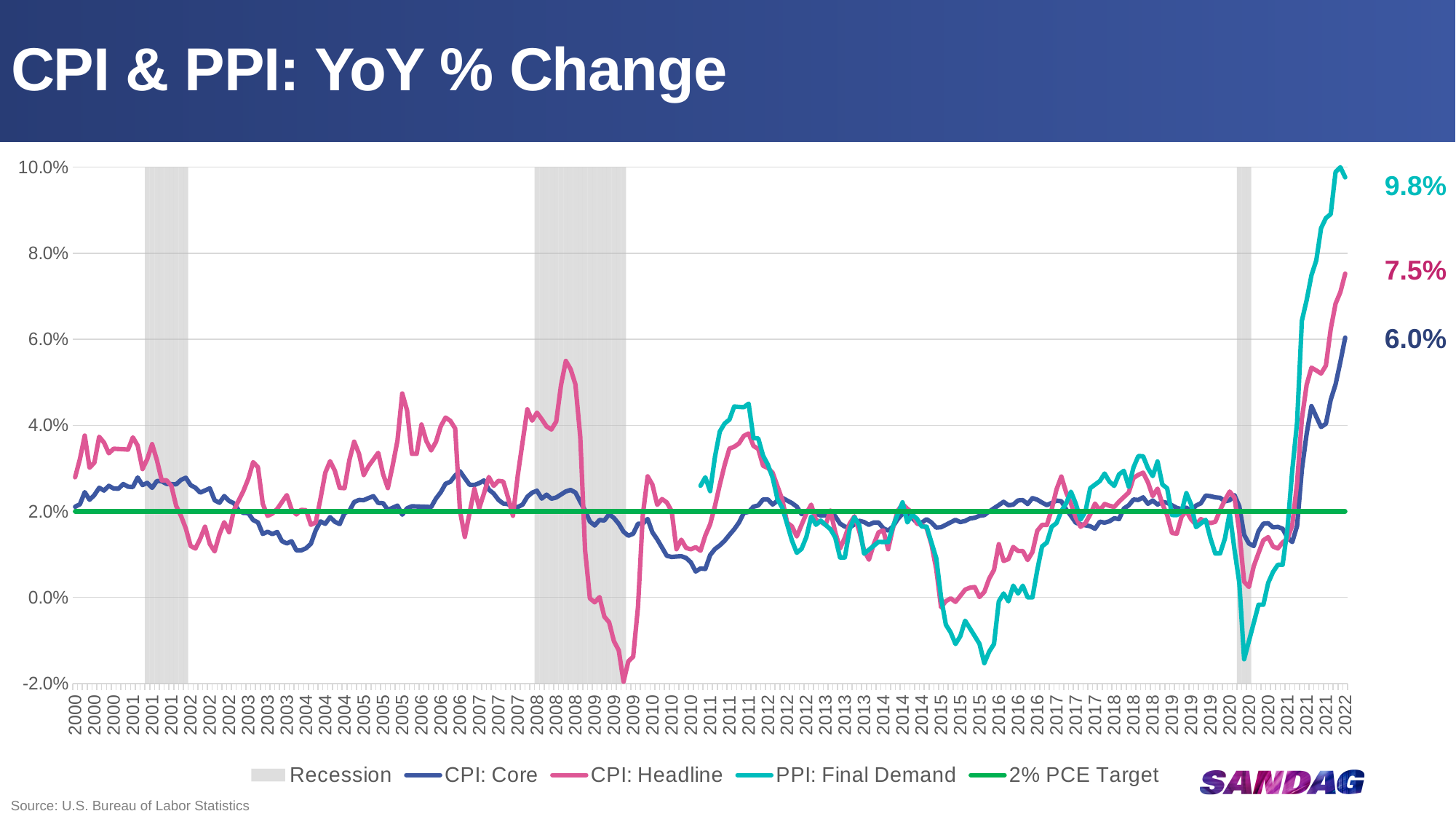
Which series has the lowest value at the end of the chart among CPI: Core, CPI: Headline and PPI: Final Demand? CPI: Core What is the latest value shown for CPI: Headline? 7.5% What kind of chart is shown on the slide? line chart Is the latest CPI: Headline value larger or smaller than the latest CPI: Core value? larger Does PPI: Final Demand rise or fall from 2020 to 2022? rise What does the flat green horizontal line represent? 2% PCE Target Is the lowest value reached by CPI: Headline in 2009 greater or less than 0.0%? less What is the latest value shown for CPI: Core? 6.0% Which series has the highest value at the end of the chart? PPI: Final Demand What is the difference between the latest PPI: Final Demand value and the latest CPI: Headline value? 2.3 percentage points What is the latest value shown for PPI: Final Demand? 9.8% How many entries does the legend list? 5